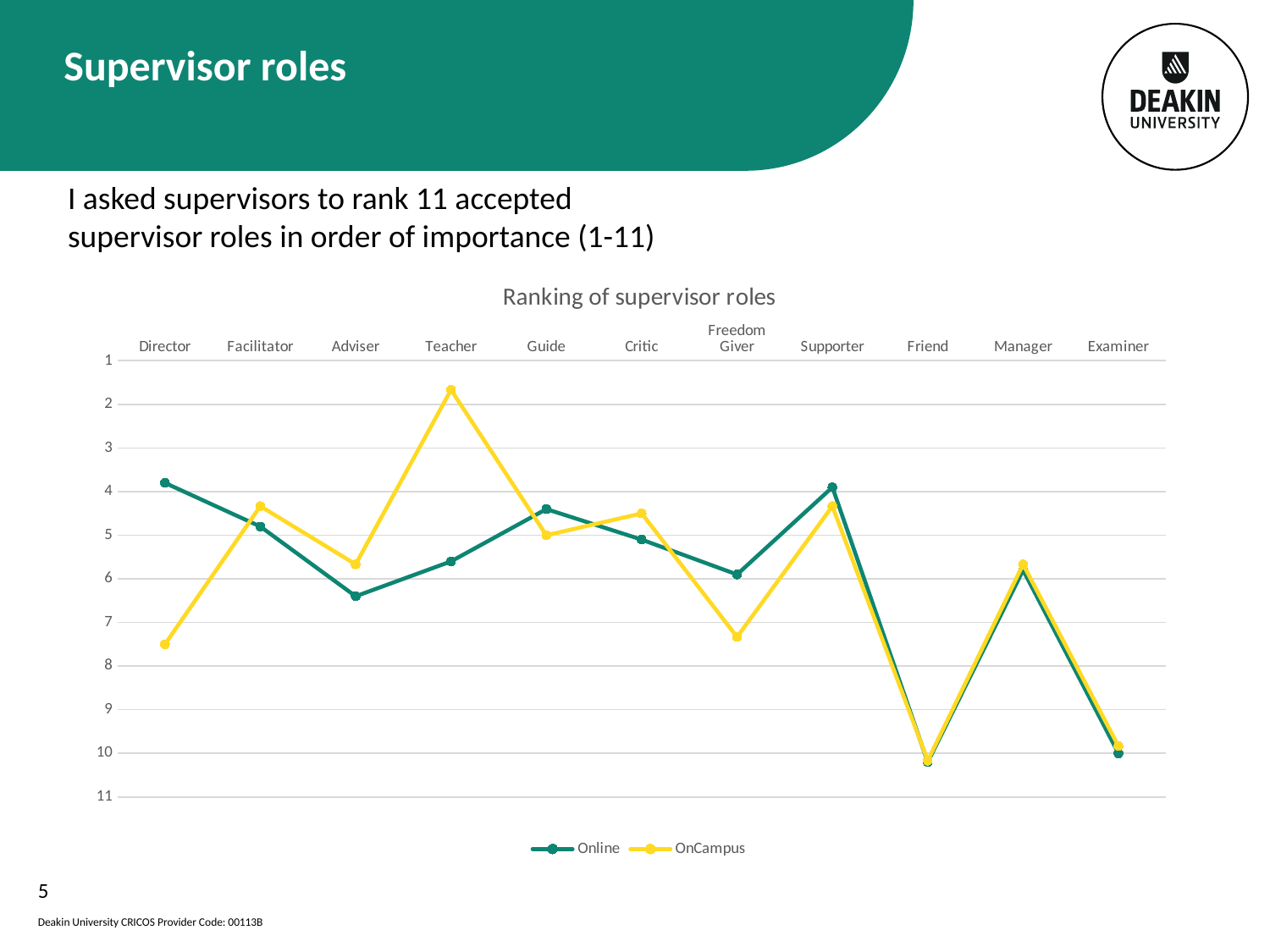
What kind of chart is shown on the slide? line chart How many supervisor roles are plotted along the x axis? 11 Is the Online value for Teacher greater or less than 5? greater Is the OnCampus value for Teacher greater or less than 3? less Is the OnCampus value for Freedom Giver greater or less than 6? greater What is the title of the chart? Ranking of supervisor roles For Director, which series has the larger value, Online or OnCampus? OnCampus For Teacher, which series has the smaller value, Online or OnCampus? OnCampus Which two series are listed in the chart's legend? Online and OnCampus How many series does the chart's legend list? 2